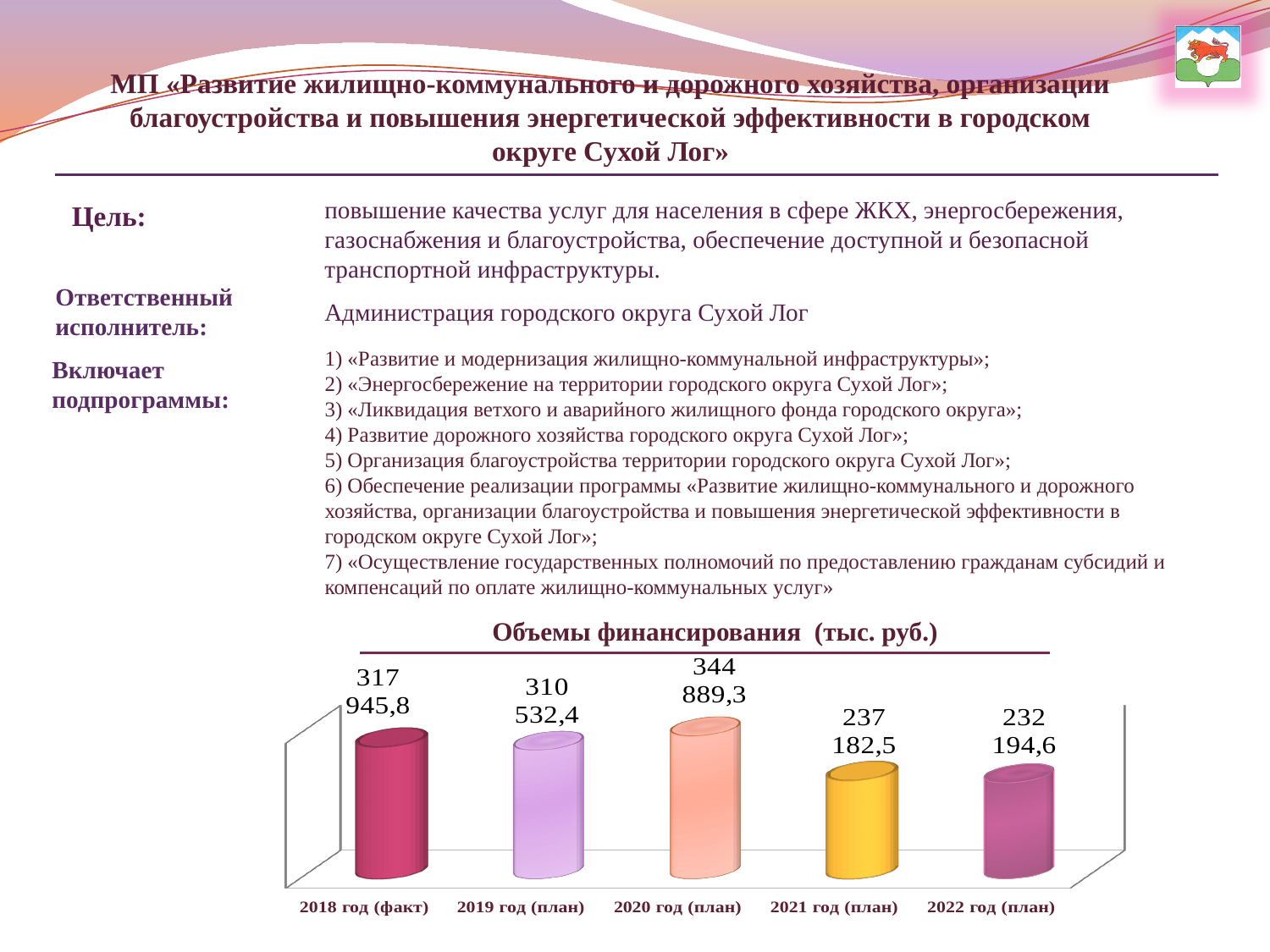
Do the values rise or fall from 2020 год (план) to 2022 год (план)? fall What is the value for 2018 год (факт) in the chart 'Объемы финансирования (тыс. руб.)'? 317 945,8 What is the difference between the values for 2020 год (план) and 2018 год (факт)? 26 943,5 What kind of chart is shown on the slide? bar chart How many years are shown in the chart? 5 What is the value for 2020 год (план) in the chart? 344 889,3 Which year has the lowest value in the chart? 2022 год (план) What is the value for 2019 год (план) in the chart? 310 532,4 What is the value for 2022 год (план) in the chart? 232 194,6 Which year has the highest value in the chart? 2020 год (план) Which is larger, the value for 2021 год (план) or 2022 год (план)? 2021 год (план) What is the difference between the values for 2021 год (план) and 2022 год (план)? 4 987,9